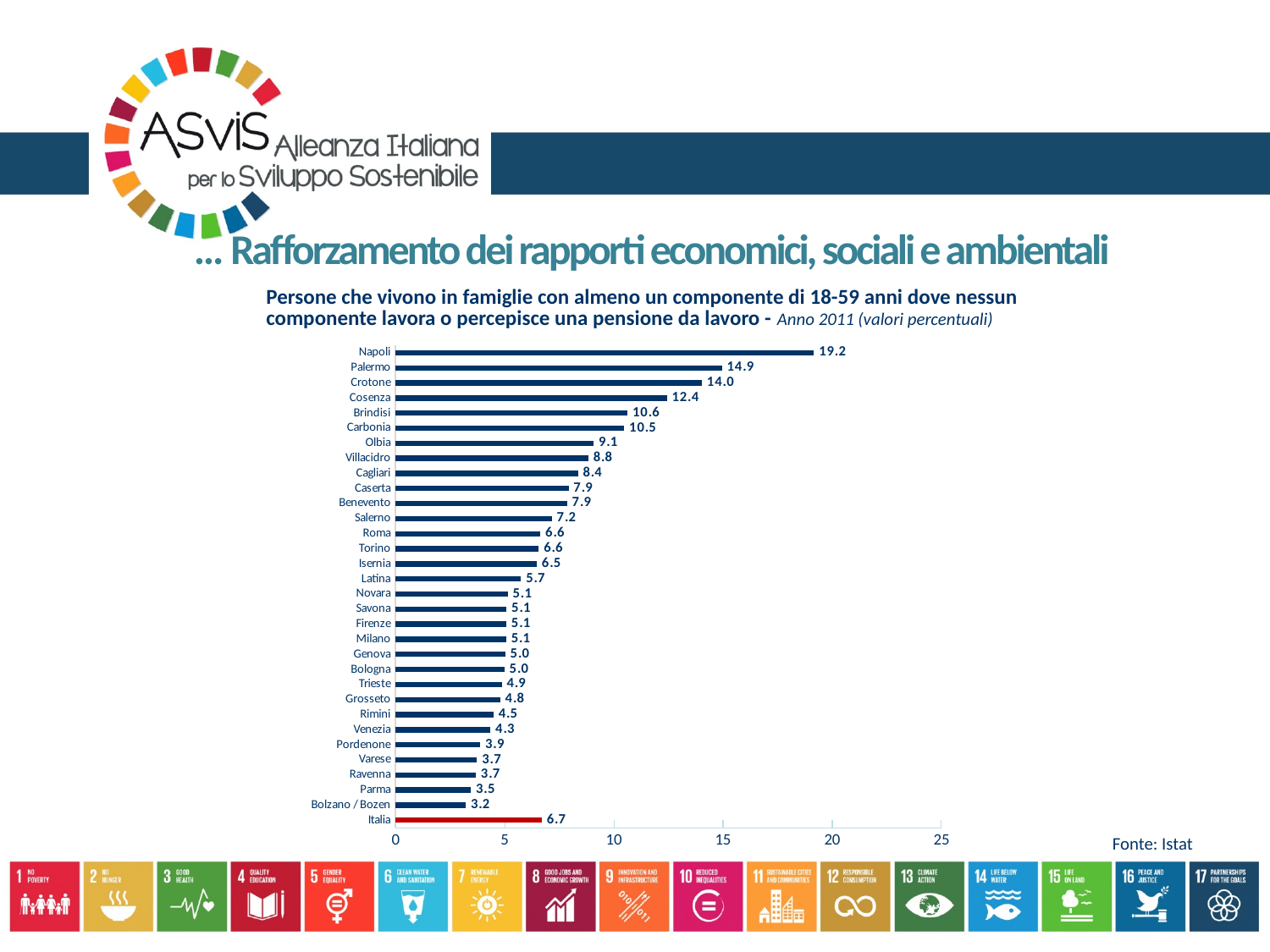
What kind of chart is shown on the slide? Bar chart What is the difference between the values for Italia and Roma? 0.1 What is the difference between the values for Napoli and Palermo? 4.3 Which category has the lowest value? Bolzano / Bozen Which category has the highest value? Napoli Which has a larger value, Crotone or Cosenza? Crotone Is the value for Brindisi greater or less than 10? greater What is the value for Italia? 6.7 What is the value for Napoli? 19.2 How many categories are shown in the chart? 32 What is the value for Bolzano / Bozen? 3.2 What is the value for Cagliari? 8.4